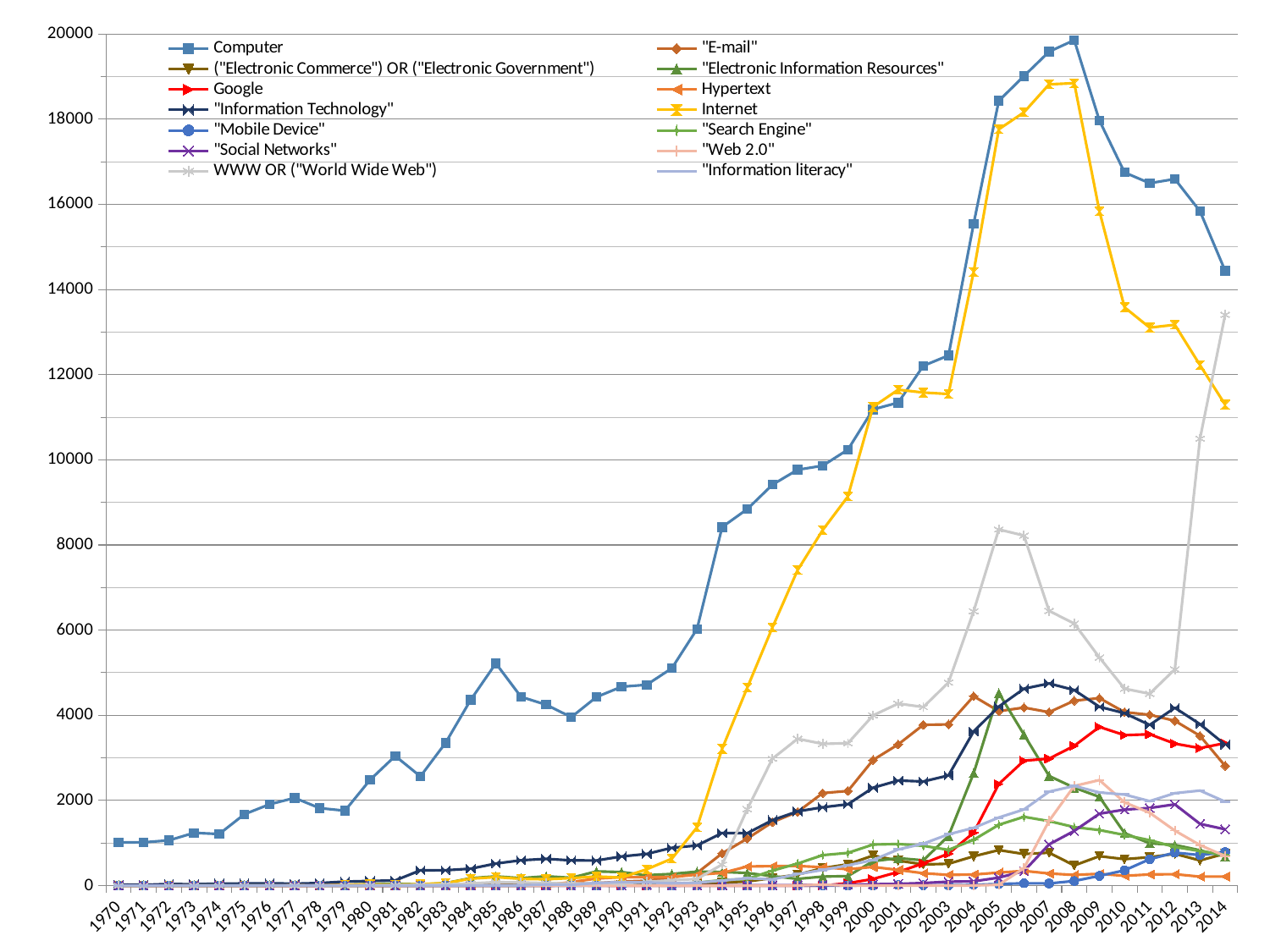
How many years are plotted along the x axis? 45 In which year does the Computer series reach its peak? 2008 What kind of chart is shown on the slide? line chart Which series reaches the highest value on the chart? Computer Is the value for Computer in 2008 greater or less than 18000? greater Does the Computer series rise or fall from 2008 to 2014? fall What colour is the Internet line? yellow Is the value for Internet in 2014 greater or less than 12000? less Is the value for Computer in 1970 greater or less than 2000? less How many series does the legend list? 14 Which is higher in 1985, Computer or Internet? Computer Which is higher in 2014, Internet or WWW OR ("World Wide Web")? WWW OR ("World Wide Web")